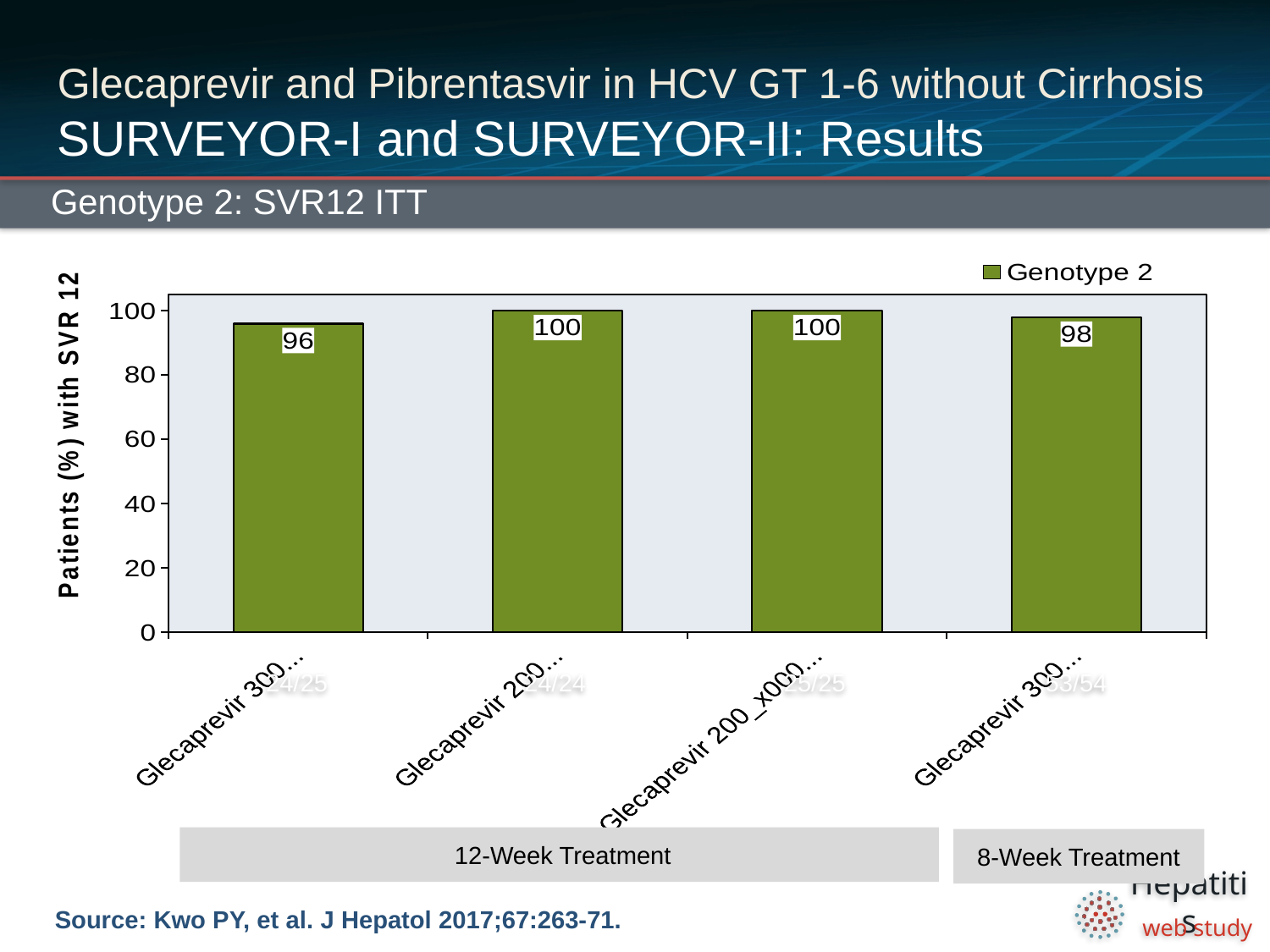
Which is larger, the value of the leftmost bar or the value of the rightmost bar? The rightmost bar (98) What is the difference between the second bar (100) and the leftmost bar (96)? 4 What is the value of the bar in the 8-Week Treatment group? 98 What is the value of the second bar from the left? 100 Which bar has the lowest value in the chart? The leftmost bar (96) How many bars fall under the 12-Week Treatment group? 3 How many series does the legend list? 1 Is the value of the leftmost bar greater or less than 80? greater What type of chart is shown on the slide? Bar chart What is the highest value shown on any bar in the chart? 100 How many bars are plotted in the chart? 4 What is the value of the leftmost bar in the chart? 96